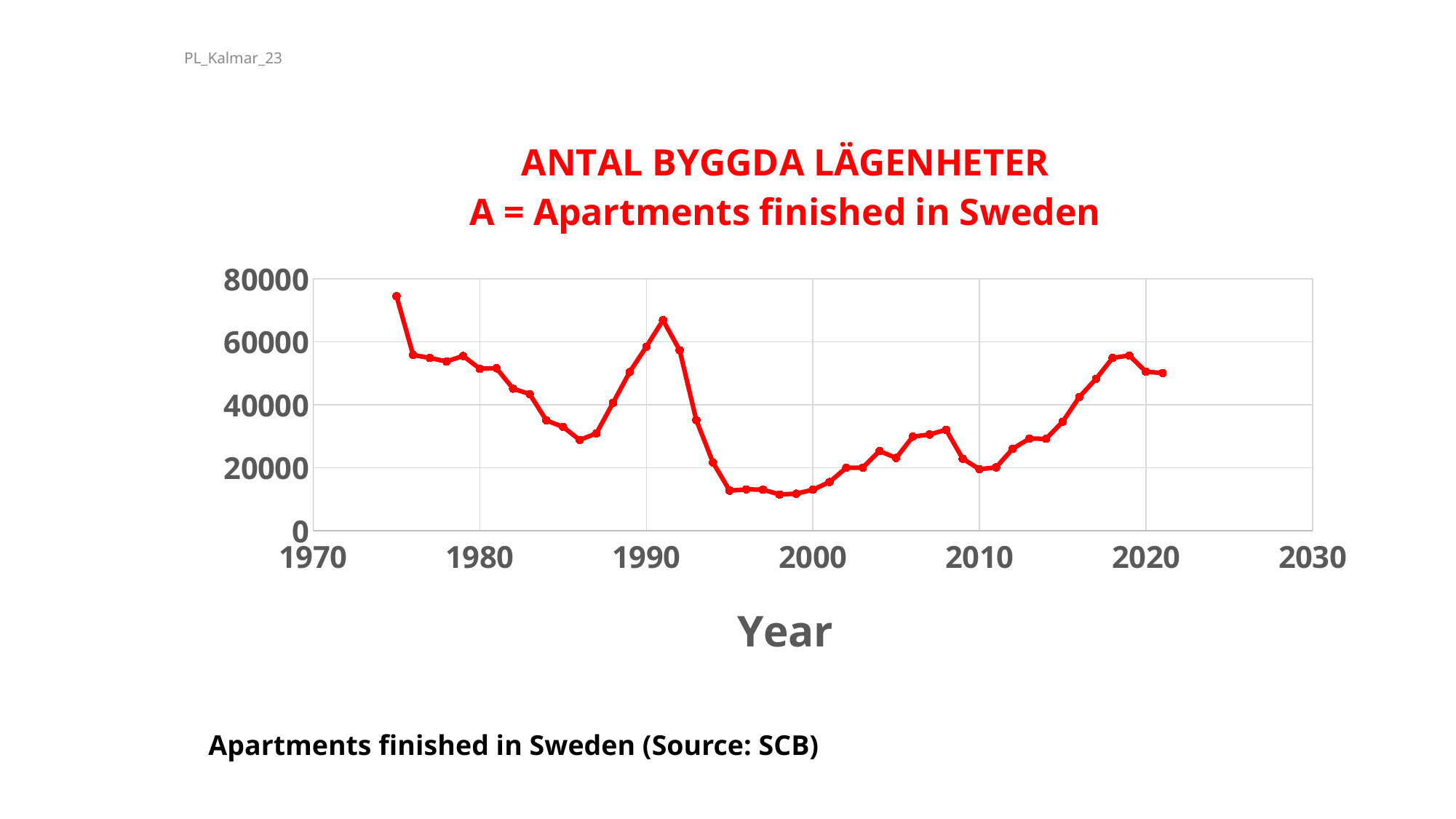
What kind of chart is shown on the slide? line chart In which year is the number of apartments finished highest? 1975 What is the label of the x axis? Year Is the value for 1975 greater or less than 60000? greater Is the value for 2000 greater or less than 20000? less Which year has the larger value, 1991 or 2018? 1991 What is the first line of the chart title? ANTAL BYGGDA LÄGENHETER Do the values rise or fall between 1991 and 1995? fall Which year has the larger value, 1986 or 1995? 1986 Is the value for 2018 greater or less than 40000? greater